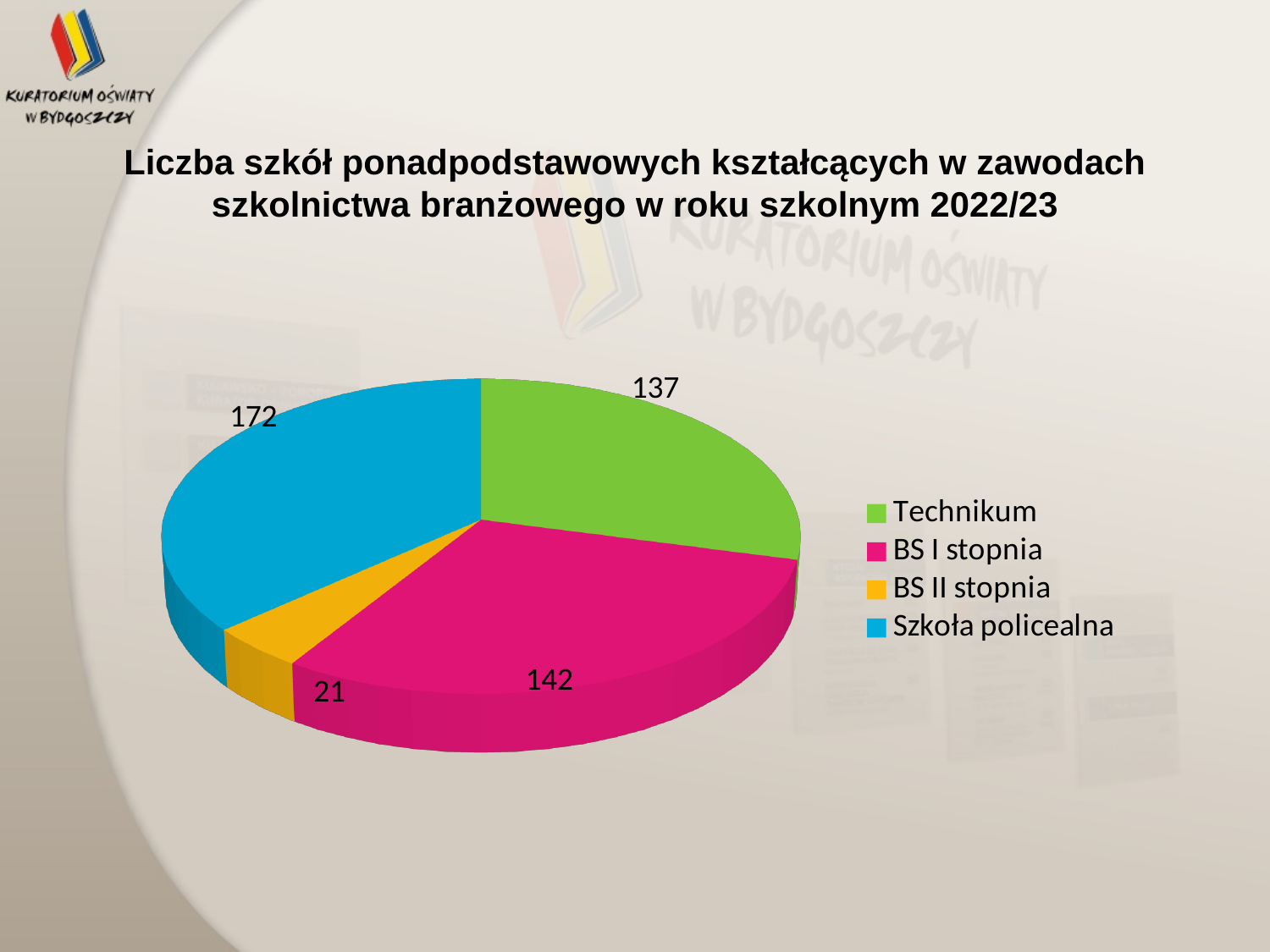
What kind of chart is shown on the slide? Pie chart What is the difference between the values for Technikum and BS II stopnia? 116 How many categories does the pie chart show? 4 What value is shown for BS II stopnia? 21 What value is shown for BS I stopnia? 142 What is the difference between the values for Szkoła policealna and BS I stopnia? 30 What is the total of all the values shown in the pie chart? 472 Which is larger, the value for BS I stopnia or the value for Technikum? BS I stopnia What value is shown for Technikum? 137 Which category has the largest slice of the pie? Szkoła policealna Which category has the smallest slice of the pie? BS II stopnia What value is shown for Szkoła policealna? 172